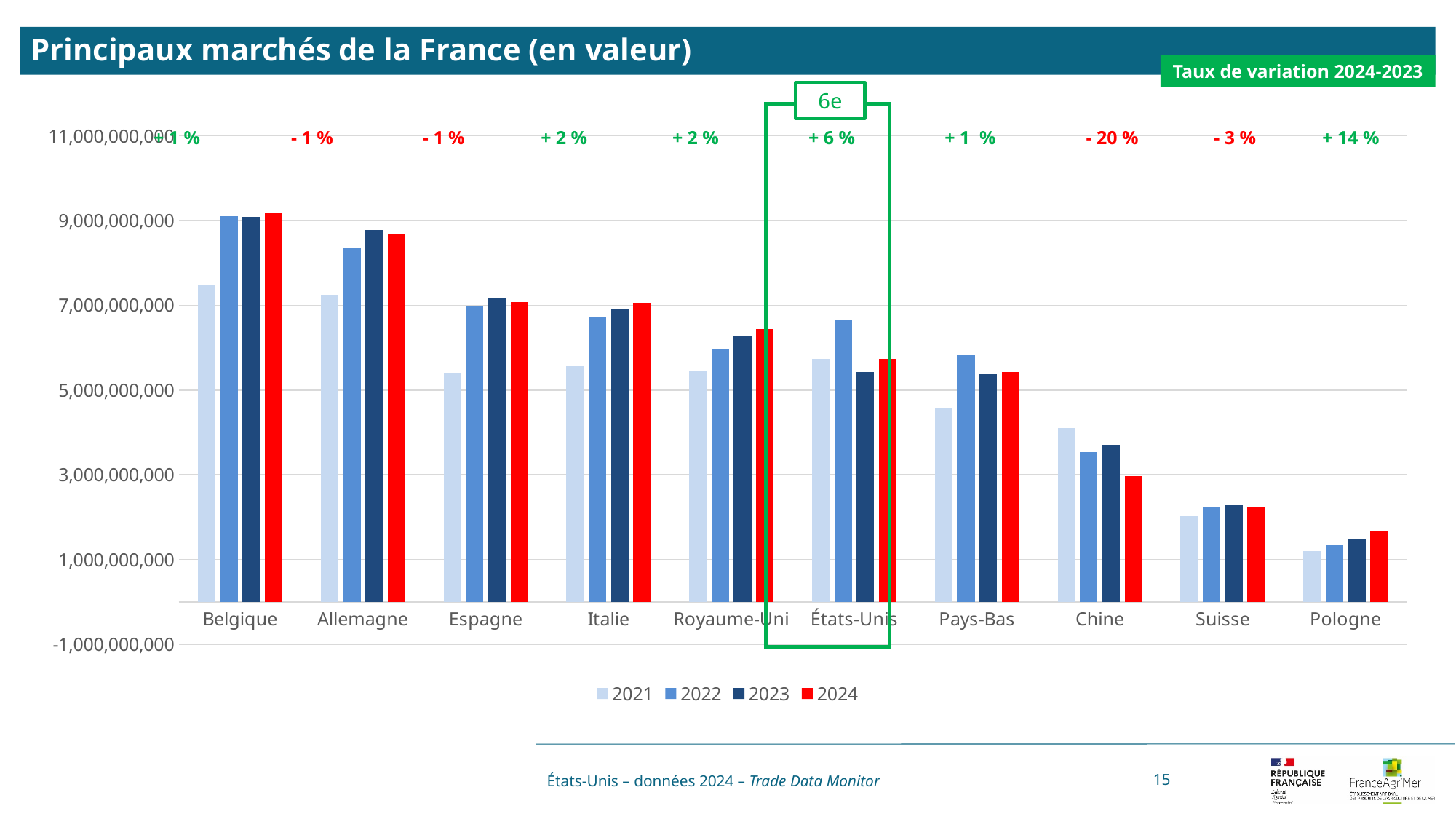
What is the 2024-2023 variation rate shown above Pologne? + 14 % Which country is marked with the green box labelled "6e"? États-Unis Is the 2022 value for Pays-Bas greater or less than 5,000,000,000? greater What kind of chart is shown on the slide? bar chart How many countries are shown on the x axis of the chart? 10 How many series does the chart legend list? 4 Which country has the highest 2024 bar? Belgique What is the 2024-2023 variation rate shown above Chine? - 20 % Which country has the lowest 2024 bar? Pologne What is the 2024-2023 variation rate shown above États-Unis? + 6 % Which is larger for Chine: the 2021 value or the 2024 value? 2021 Is the 2022 value for États-Unis greater or less than 7,000,000,000? less